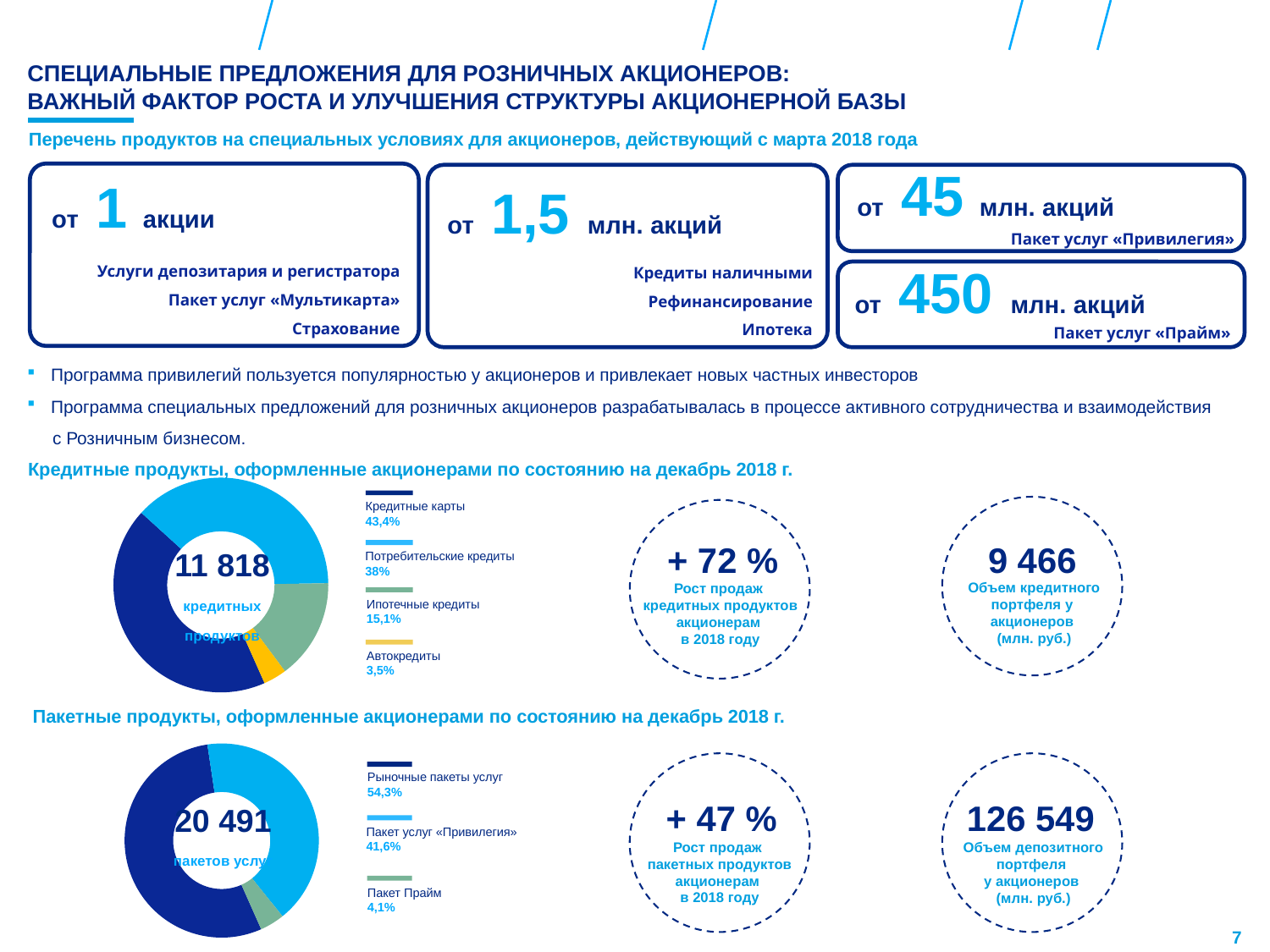
In the chart 'Кредитные продукты, оформленные акционерами по состоянию на декабрь 2018 г.', which category has the smallest share? Автокредиты In the chart 'Кредитные продукты, оформленные акционерами по состоянию на декабрь 2018 г.', what is the difference in percentage points between Кредитные карты and Потребительские кредиты? 5,4 What total number is shown in the centre of the chart 'Кредитные продукты, оформленные акционерами по состоянию на декабрь 2018 г.'? 11 818 How many categories does the chart 'Кредитные продукты, оформленные акционерами по состоянию на декабрь 2018 г.' show? 4 How many categories does the chart 'Пакетные продукты, оформленные акционерами по состоянию на декабрь 2018 г.' show? 3 In the chart 'Пакетные продукты, оформленные акционерами по состоянию на декабрь 2018 г.', what share do Рыночные пакеты услуг have? 54,3% In the chart 'Кредитные продукты, оформленные акционерами по состоянию на декабрь 2018 г.', what share do Ипотечные кредиты have? 15,1% In the chart 'Пакетные продукты, оформленные акционерами по состоянию на декабрь 2018 г.', which is larger: Рыночные пакеты услуг or Пакет услуг «Привилегия»? Рыночные пакеты услуг In the chart 'Пакетные продукты, оформленные акционерами по состоянию на декабрь 2018 г.', what share does Пакет Прайм have? 4,1% What type of chart is used for 'Пакетные продукты, оформленные акционерами по состоянию на декабрь 2018 г.'? Pie (donut) chart In the chart 'Кредитные продукты, оформленные акционерами по состоянию на декабрь 2018 г.', what share do Кредитные карты have? 43,4% In the chart 'Кредитные продукты, оформленные акционерами по состоянию на декабрь 2018 г.', which category has the largest share? Кредитные карты